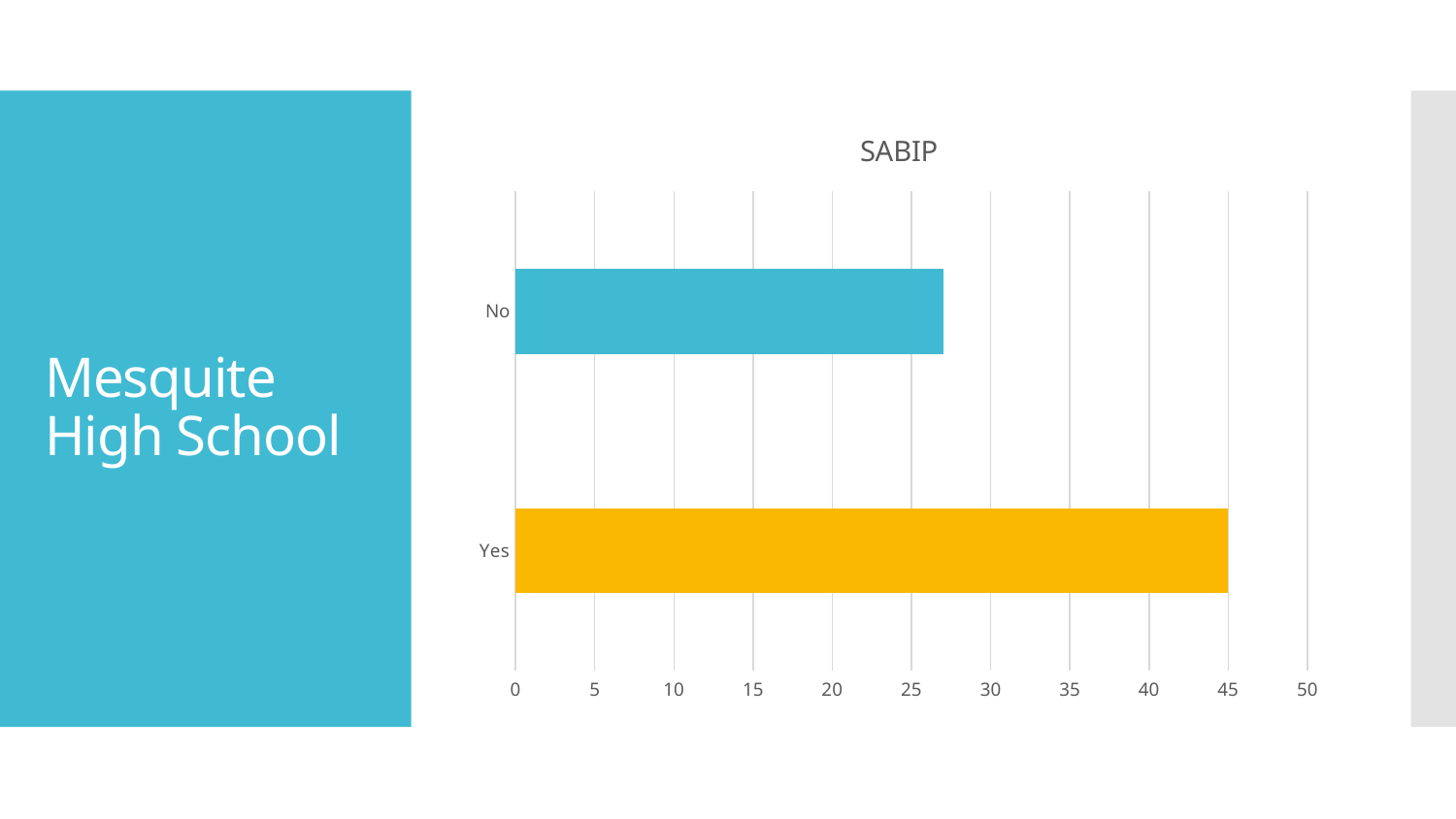
Is the value for No greater or less than 25? greater What is the title of the chart on the slide? SABIP Is the value for Yes greater or less than 40? greater How many categories are shown in the SABIP chart? 2 Which is larger, the value for Yes or the value for No? Yes What is the value for Yes in the SABIP chart? 45 Which category has the highest value in the SABIP chart? Yes Which category has the lowest value in the SABIP chart? No What kind of chart is shown on the slide? bar chart What colour is the bar for Yes? yellow Is the value for No greater or less than 30? less